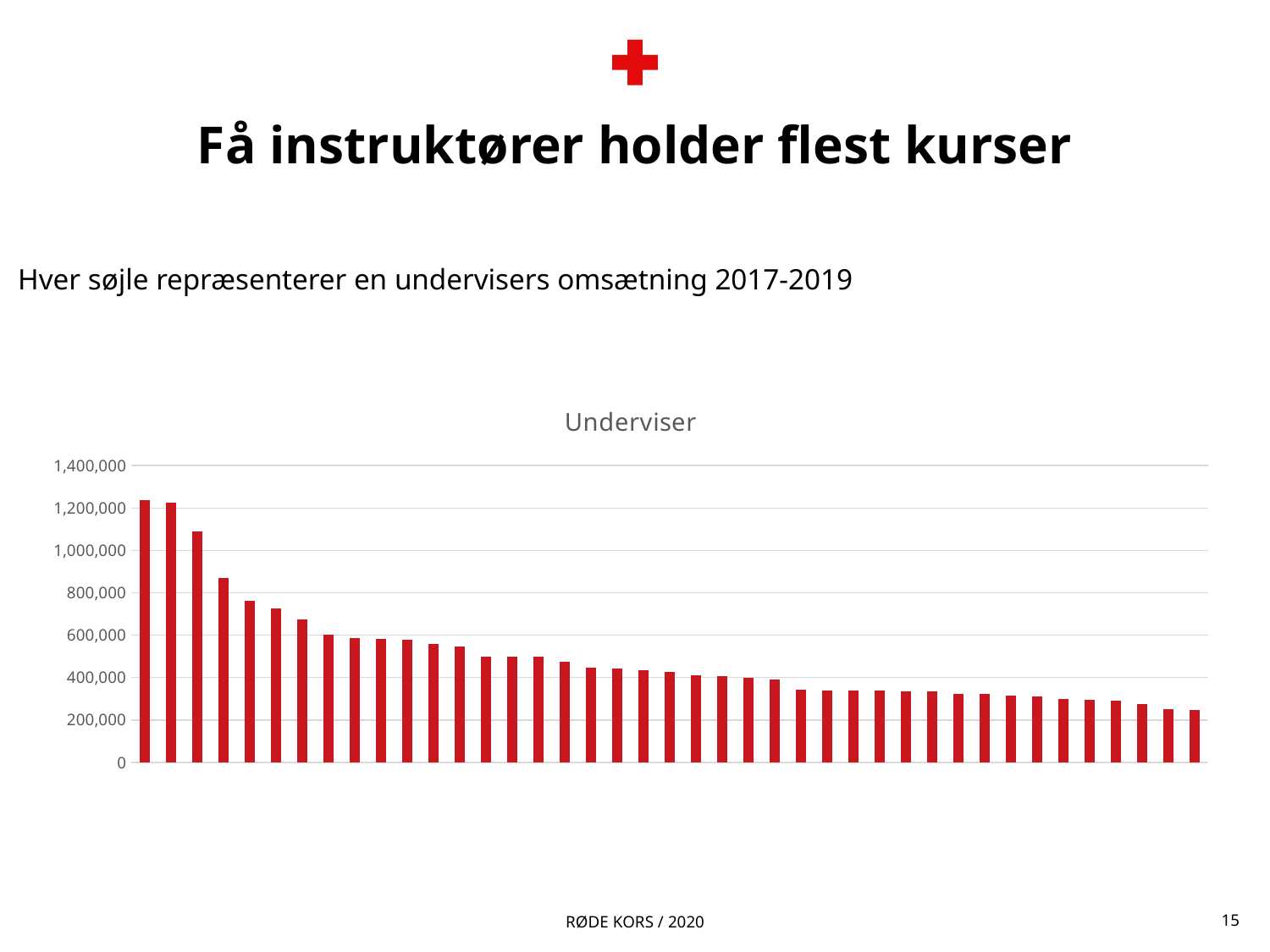
What is the highest value shown on the vertical axis of the chart? 1,400,000 Is the value of the leftmost bar greater or less than 1,000,000? greater What is the title of the chart? Underviser Do the bar values rise or fall from left to right across the chart? fall Which bar is the highest in the chart, the leftmost or the rightmost? the leftmost What kind of chart is shown on the slide? bar chart Is the value of the fourth bar from the left greater or less than 1,000,000? less Which is larger, the value of the second bar from the left or the value of the fifth bar from the left? the second bar from the left Is the value of the rightmost bar greater or less than 400,000? less Which bar is the lowest in the chart, the leftmost or the rightmost? the rightmost